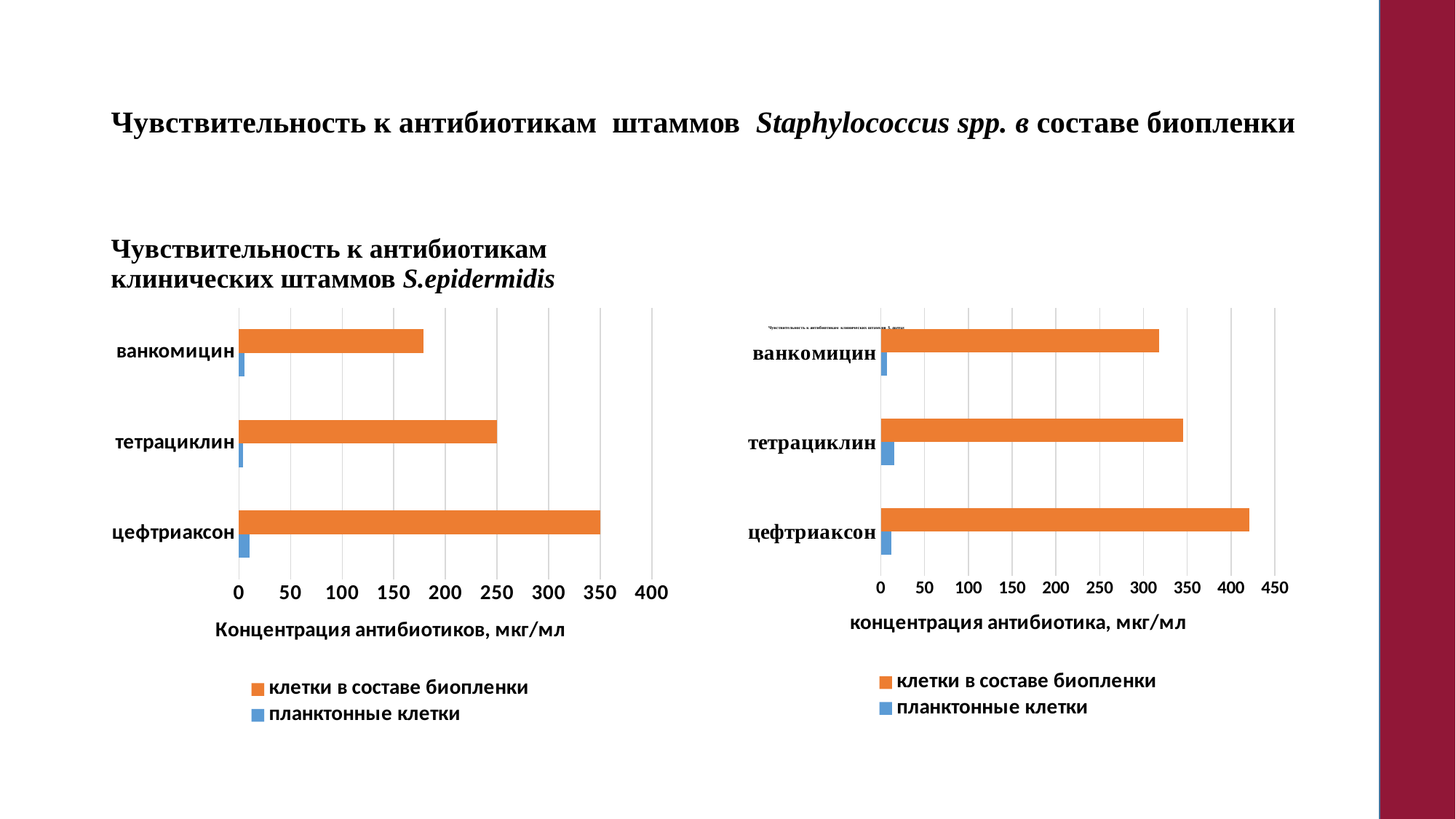
On the left chart, which antibiotic has the highest value for 'клетки в составе биопленки'? цефтриаксон On the left chart, is the 'клетки в составе биопленки' value for ванкомицин greater or less than 200? less On the left chart, which antibiotic has the lowest value for 'клетки в составе биопленки'? ванкомицин On the right chart, is the 'клетки в составе биопленки' value for цефтриаксон greater or less than 400? greater On the left chart, what is the value for тетрациклин in the series 'клетки в составе биопленки'? 250 What kind of chart is the left chart, titled 'Чувствительность к антибиотикам клинических штаммов S.epidermidis'? bar chart On the left chart, what is the difference between the 'клетки в составе биопленки' values for цефтриаксон and тетрациклин? 100 What is the x-axis title of the left chart? Концентрация антибиотиков, мкг/мл On the left chart, what is the value for цефтриаксон in the series 'клетки в составе биопленки'? 350 On the right chart, which antibiotic has the highest value for 'клетки в составе биопленки'? цефтриаксон How many series does the legend of the left chart list? 2 How many antibiotics (categories) are shown on the left chart? 3